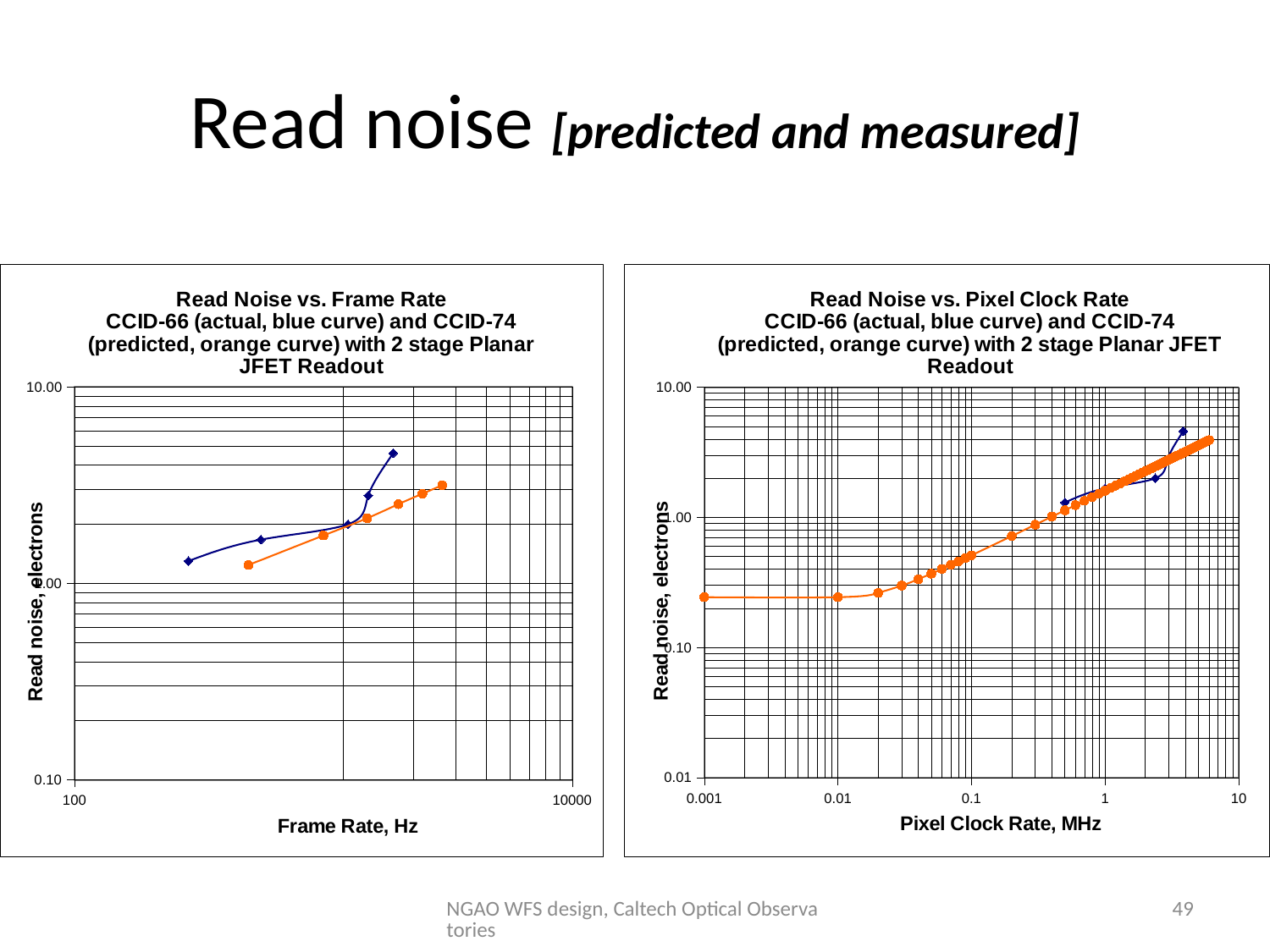
In the left chart 'Read Noise vs. Frame Rate', is the read noise of the blue curve at its lowest plotted frame rate greater or less than 1.00 electrons? greater According to the chart titles, which colour curve represents the CCID-74 predicted read noise? orange In the left chart 'Read Noise vs. Frame Rate', is the read noise of the orange curve at its highest plotted frame rate greater or less than 10.00 electrons? less In the right chart 'Read Noise vs. Pixel Clock Rate', which curve extends to the lowest pixel clock rate, blue or orange? orange What kind of chart is the left chart, 'Read Noise vs. Frame Rate'? line chart In the right chart 'Read Noise vs. Pixel Clock Rate', is the read noise of the orange curve at 0.001 MHz greater or less than 1.00 electrons? less In the right chart 'Read Noise vs. Pixel Clock Rate', does the orange curve rise or fall as pixel clock rate increases above 0.01 MHz? rise In the left chart 'Read Noise vs. Frame Rate', does the read noise of the blue curve rise or fall as frame rate increases? rise What is the x-axis title of the left chart? Frame Rate, Hz In the left chart 'Read Noise vs. Frame Rate', at the highest frame rate plotted for the blue curve, which curve shows the higher read noise, blue or orange? blue